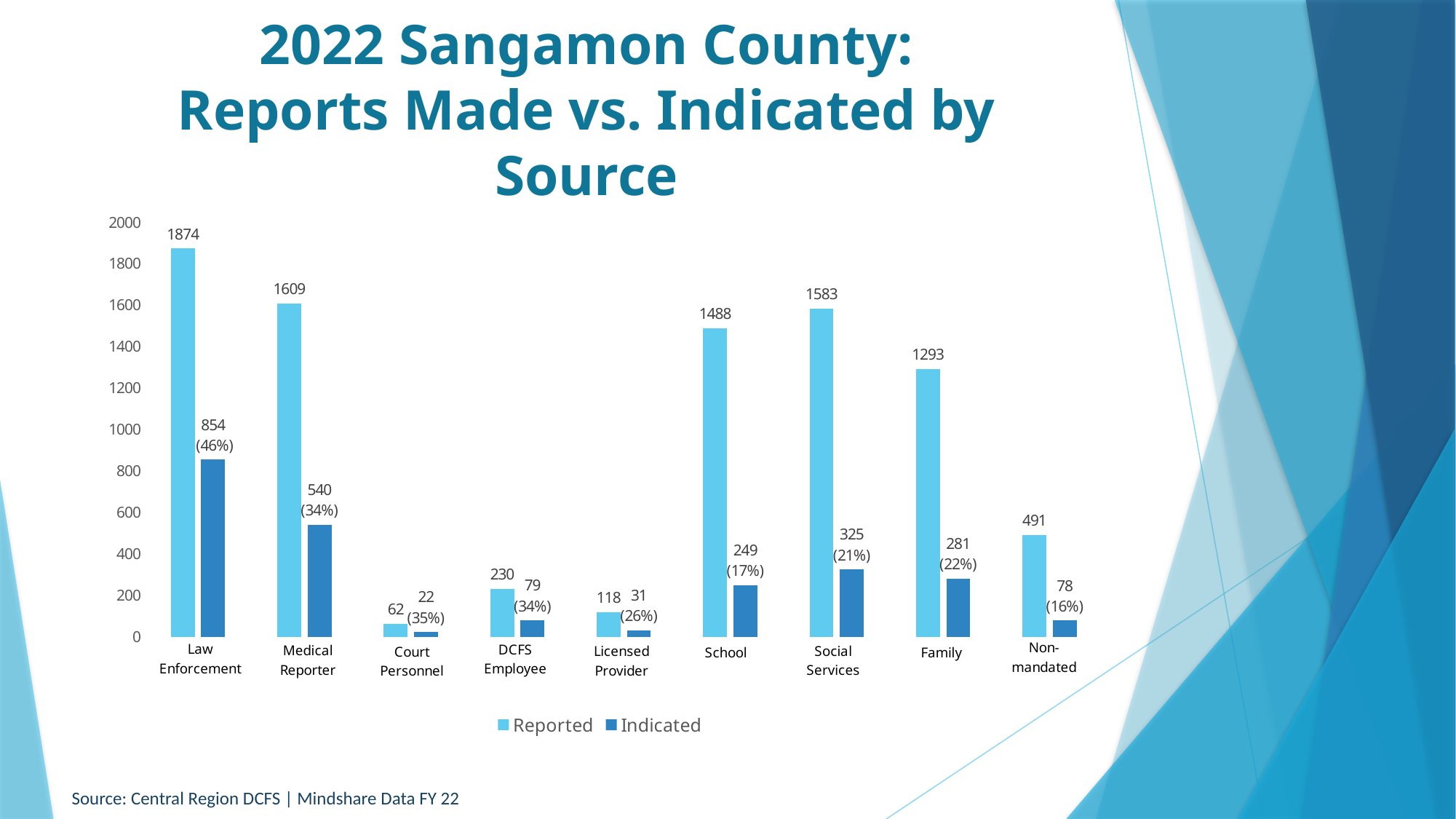
What is the Reported value for School? 1488 What kind of chart is shown on the slide? Bar chart What percentage is shown next to the Indicated value for Non-mandated? 16% How many source categories are shown on the x axis? 9 What is the Indicated value for Medical Reporter? 540 Which is larger, the Reported value for Family or the Reported value for School? School How many reports were made by Law Enforcement? 1874 Which source has the lowest Indicated value? Court Personnel Which source has the highest Reported value? Law Enforcement How many series does the legend list? 2 What is the title of the chart? 2022 Sangamon County: Reports Made vs. Indicated by Source What is the difference between the Reported and Indicated values for Social Services? 1258